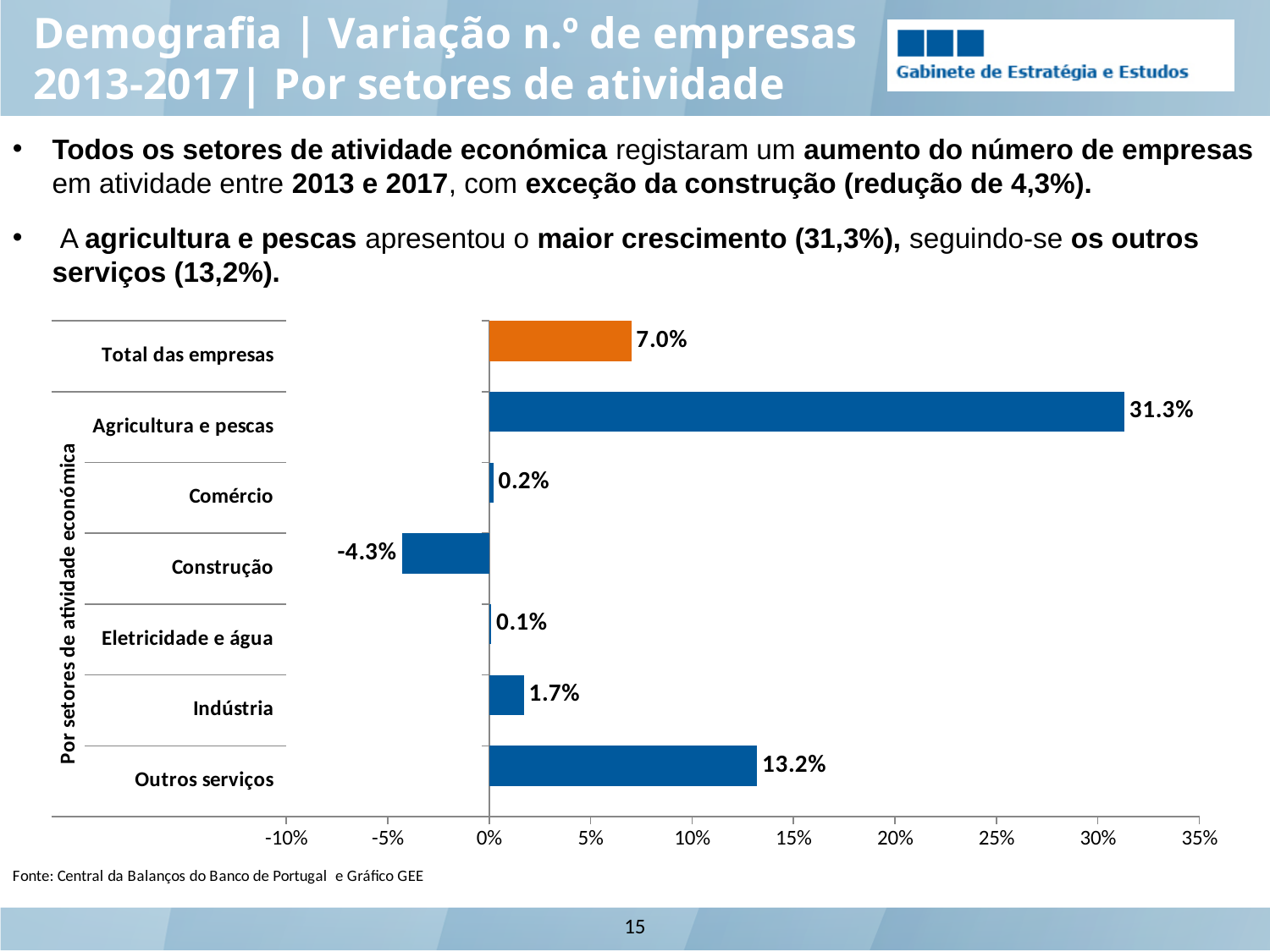
What is the difference between the values for Agricultura e pescas and Outros serviços? 18.1% What is the value shown for Construção? -4.3% How many categories are shown on the chart? 7 Which category has the highest value? Agricultura e pescas Is the value for Outros serviços greater or less than 10%? greater Which bar is shown in a different colour (orange) from the others? Total das empresas What is the value shown for Agricultura e pescas? 31.3% What is the value shown for Total das empresas? 7.0% What kind of chart is shown on the slide? bar chart What is the value shown for Outros serviços? 13.2% Which category has the lowest value? Construção Which is larger, the value for Indústria or the value for Comércio? Indústria